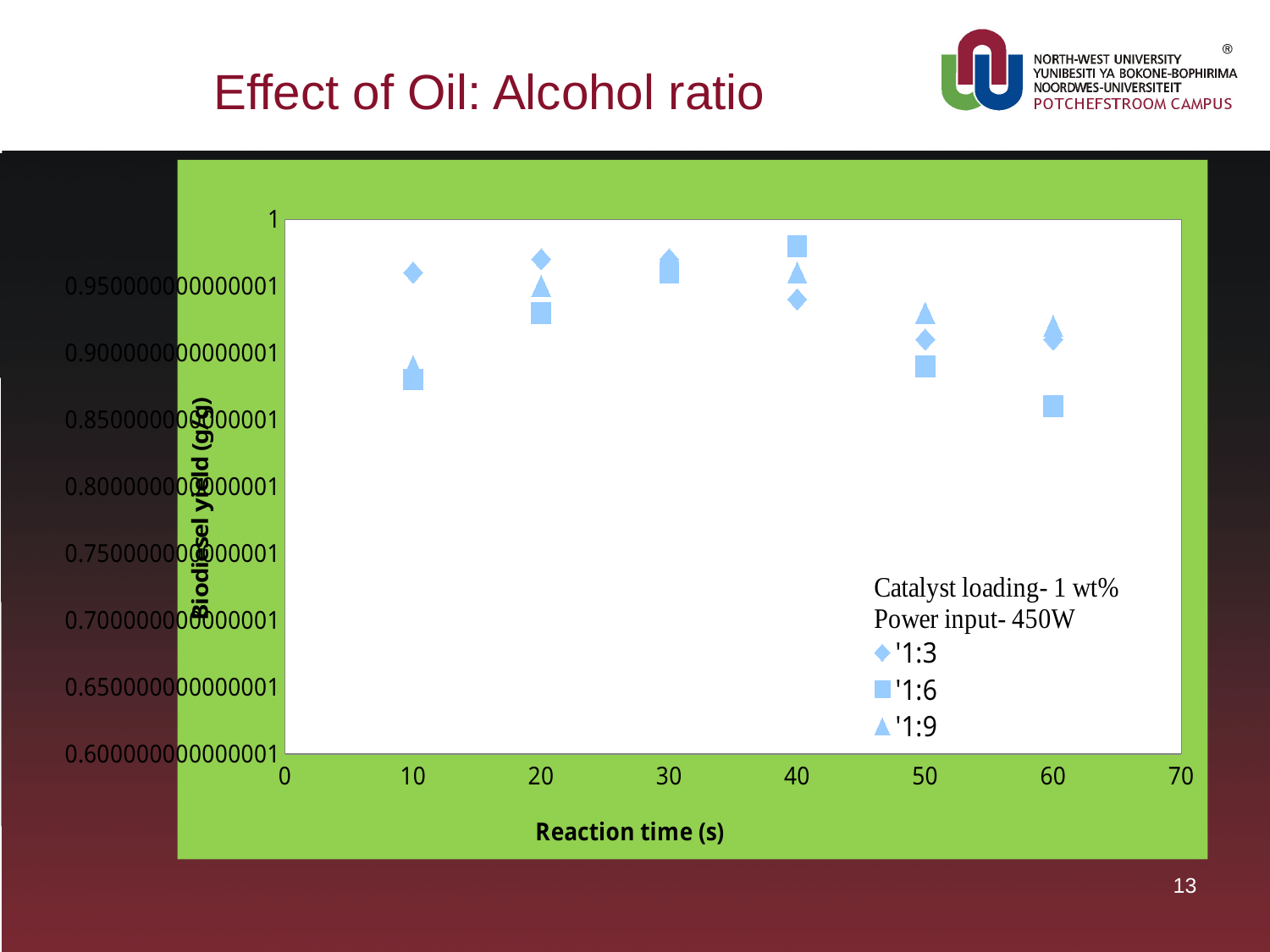
What kind of chart is shown on the slide? scatter chart Is the value for the '1:9 series at 50 s greater or less than 0.9? greater At which reaction time does the '1:6 series reach its highest biodiesel yield? 40 Is the value for the '1:6 series at 40 s greater or less than 0.95? greater What are the three series listed in the legend? '1:3, '1:6, '1:9 How many reaction-time points are plotted for the '1:6 series? 6 At 60 s, which series has the higher biodiesel yield, '1:3 or '1:6? '1:3 What is the title of the x axis? Reaction time (s) Is the value for the '1:6 series at 60 s greater or less than 0.9? less How many series does the legend list? 3 Does the biodiesel yield for the '1:3 series rise or fall overall from 10 s to 60 s? fall